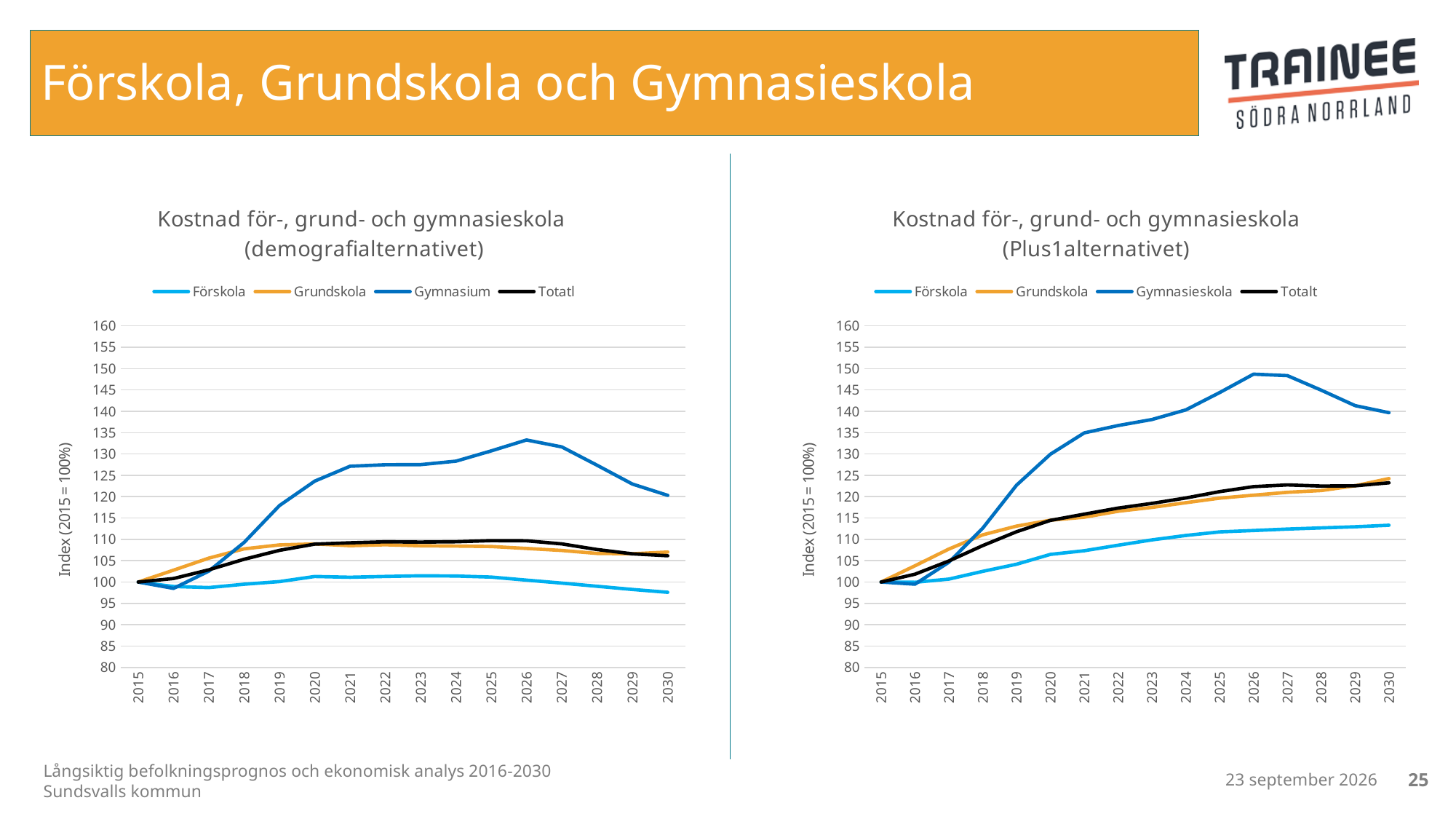
In the left chart (demografialternativet), is the value for Gymnasium in 2026 greater or less than 130? greater In the left chart (demografialternativet), does the Gymnasium line rise or fall from 2026 to 2030? fall In the left chart (demografialternativet), what is the index value for Totatl in 2015? 100 In the right chart (Plus1alternativet), does the Förskola line rise or fall from 2015 to 2030? rise In the left chart (demografialternativet), is the value for Förskola in 2030 greater or less than 100? less What kind of chart is the left chart (demografialternativet)? line chart In the right chart (Plus1alternativet), is the value for Gymnasieskola in 2026 greater or less than 145? greater How many years are shown on the x axis of the left chart (demografialternativet)? 16 In the right chart (Plus1alternativet), which is larger in 2030: Gymnasieskola or Förskola? Gymnasieskola What is the y-axis title of the right chart (Plus1alternativet)? Index (2015 = 100%) In the left chart (demografialternativet), which series has the highest value in 2026? Gymnasium How many series does the legend of the right chart (Plus1alternativet) list? 4